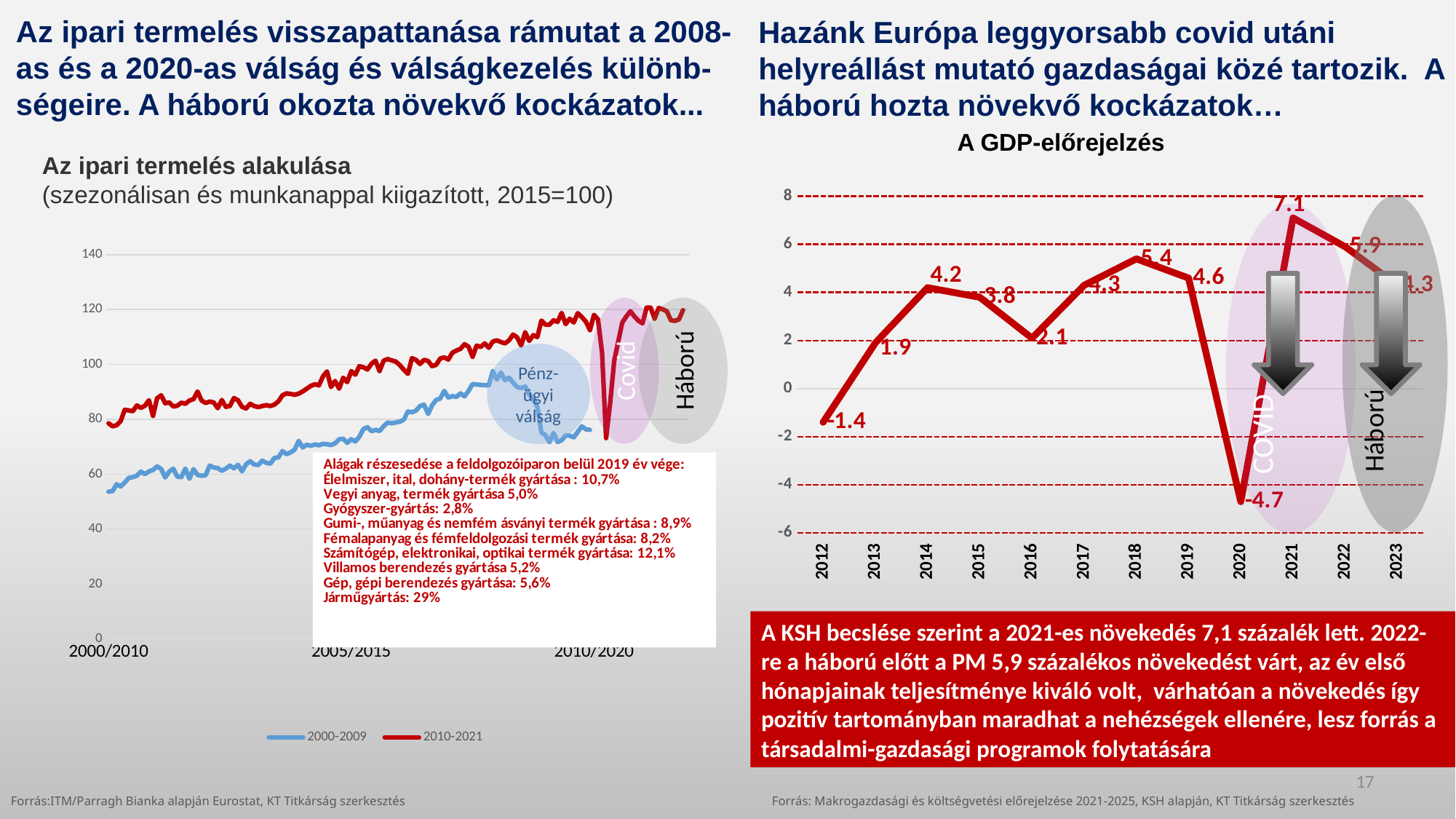
How many series does the legend of the chart 'Az ipari termelés alakulása' list? 2 In the chart titled 'A GDP-előrejelzés', which is larger, the value for 2018 or the value for 2019? 2018 In the chart titled 'A GDP-előrejelzés', which year has the highest value? 2021 What kind of chart is 'Az ipari termelés alakulása'? line chart In the chart titled 'A GDP-előrejelzés', which year has the lowest value? 2020 In the chart titled 'A GDP-előrejelzés', how many years are shown on the x axis? 12 In the chart 'Az ipari termelés alakulása', is the value of the 2000-2009 series at the start (2000) greater or less than 60? less In the chart titled 'A GDP-előrejelzés', what is the value for 2021? 7.1 In the chart titled 'A GDP-előrejelzés', what is the value for 2020? -4.7 In the chart titled 'A GDP-előrejelzés', what is the value for 2012? -1.4 In the chart titled 'A GDP-előrejelzés', do the values rise or fall from 2021 to 2023? fall In the chart titled 'A GDP-előrejelzés', what is the difference between the values for 2021 and 2022? 1.2